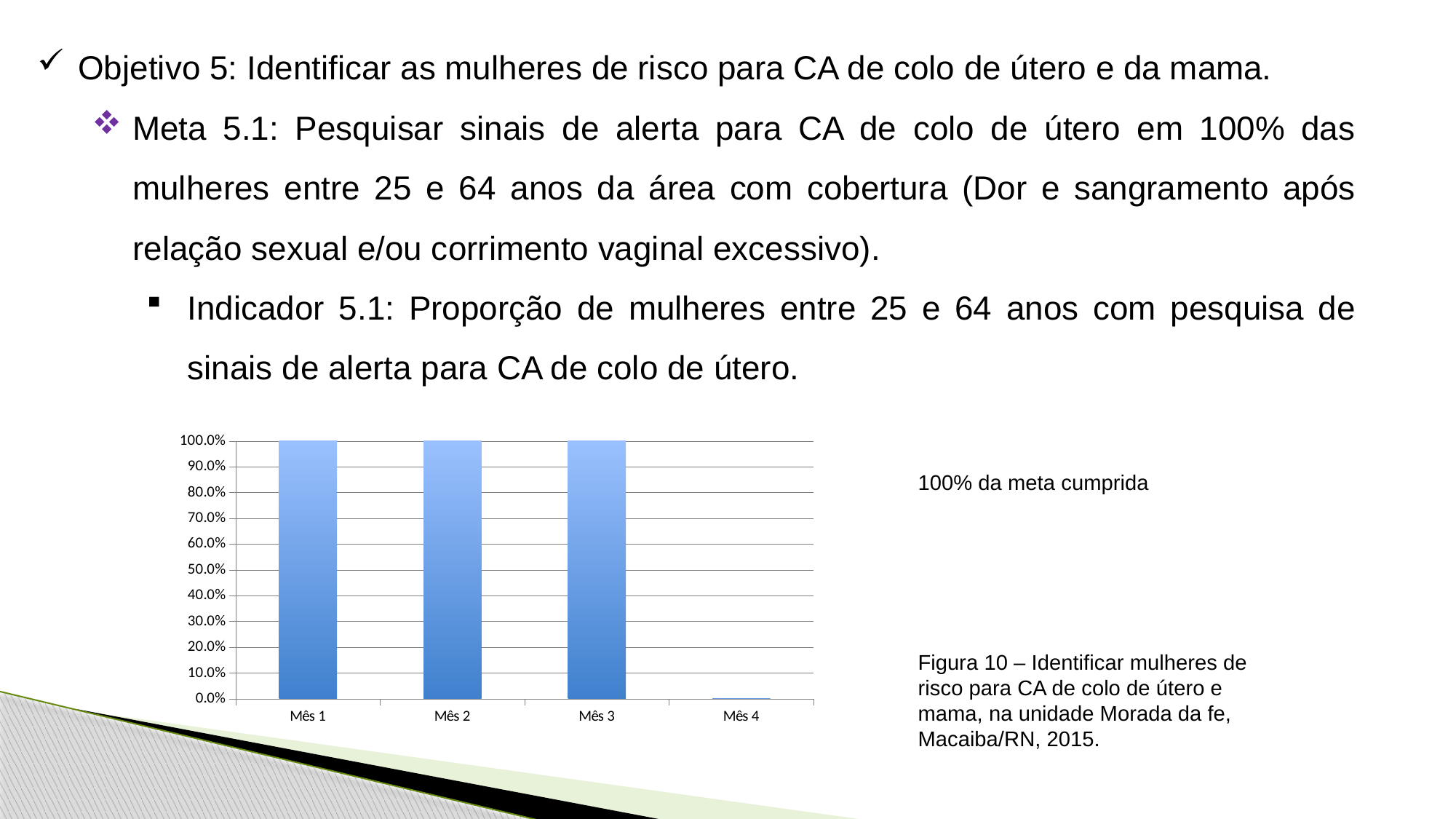
What figure number is given in the caption next to the chart? Figura 10 Is the value for Mês 3 greater or less than 50.0%? greater What is the highest tick value shown on the vertical axis? 100.0% Which month has the lowest value? Mês 4 What is the difference between the values for Mês 1 and Mês 4? 100.0% Which is larger, the value for Mês 2 or the value for Mês 4? Mês 2 What kind of chart is shown on the slide? bar chart What is the value for Mês 4? 0.0% What is the value for Mês 1? 100.0% How many months (categories) are shown on the x axis? 4 What is the value for Mês 3? 100.0% Do the values rise or fall from Mês 3 to Mês 4? fall